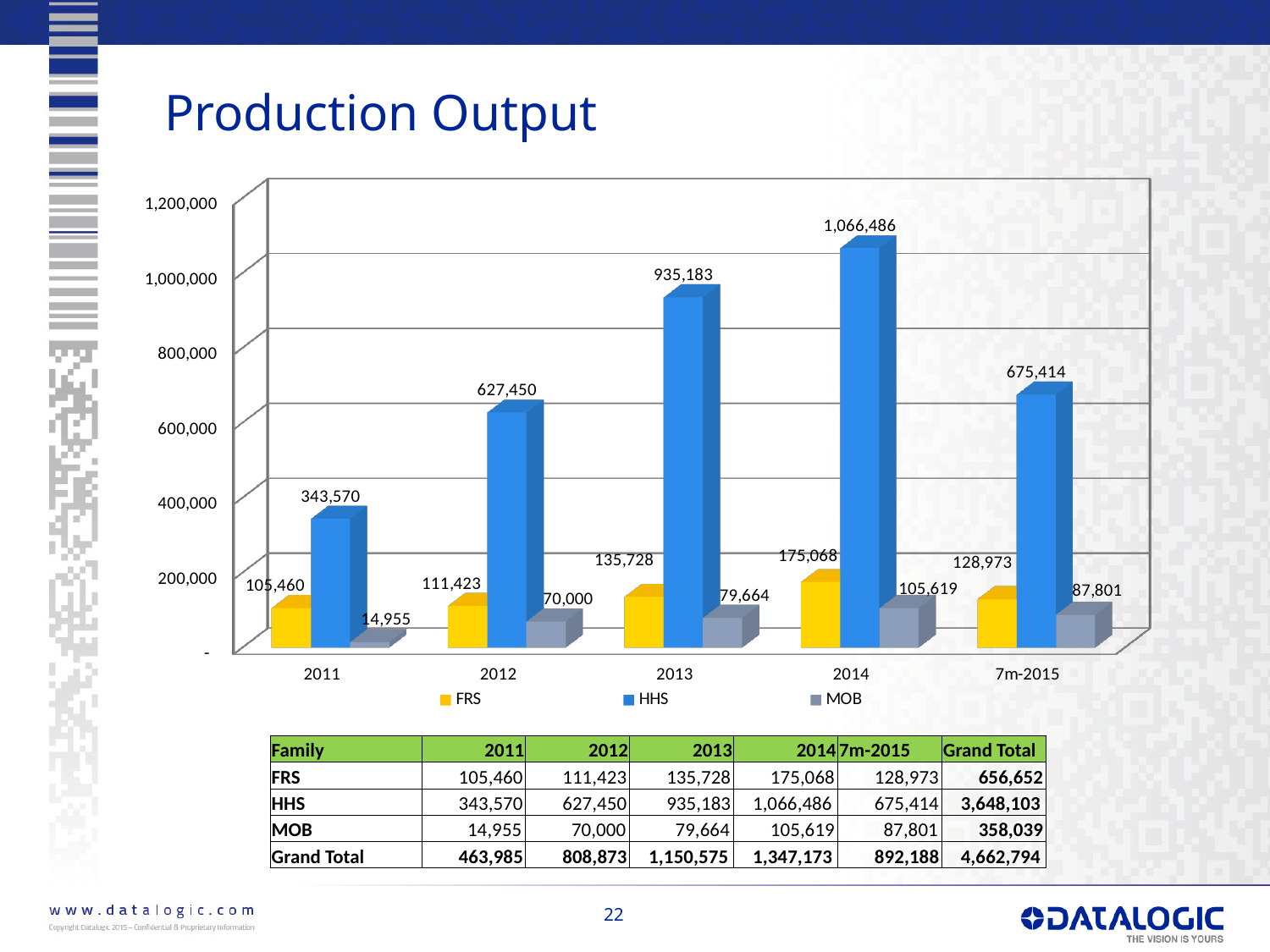
How many series does the chart legend list? 3 What is the HHS value for 2013? 935,183 What is the difference between the HHS values for 2014 and 2013? 131,303 In which year is the MOB value lowest? 2011 In which year is the HHS value highest? 2014 How many periods are shown on the x axis of the chart? 5 Do the HHS values rise or fall from 2011 to 2014? rise What kind of chart is shown on the slide? bar chart What is the FRS value for 7m-2015? 128,973 What is the MOB value for 2011? 14,955 Is the HHS value for 2012 greater or less than 600,000? greater Which is larger, the FRS value for 2014 or the FRS value for 7m-2015? 2014